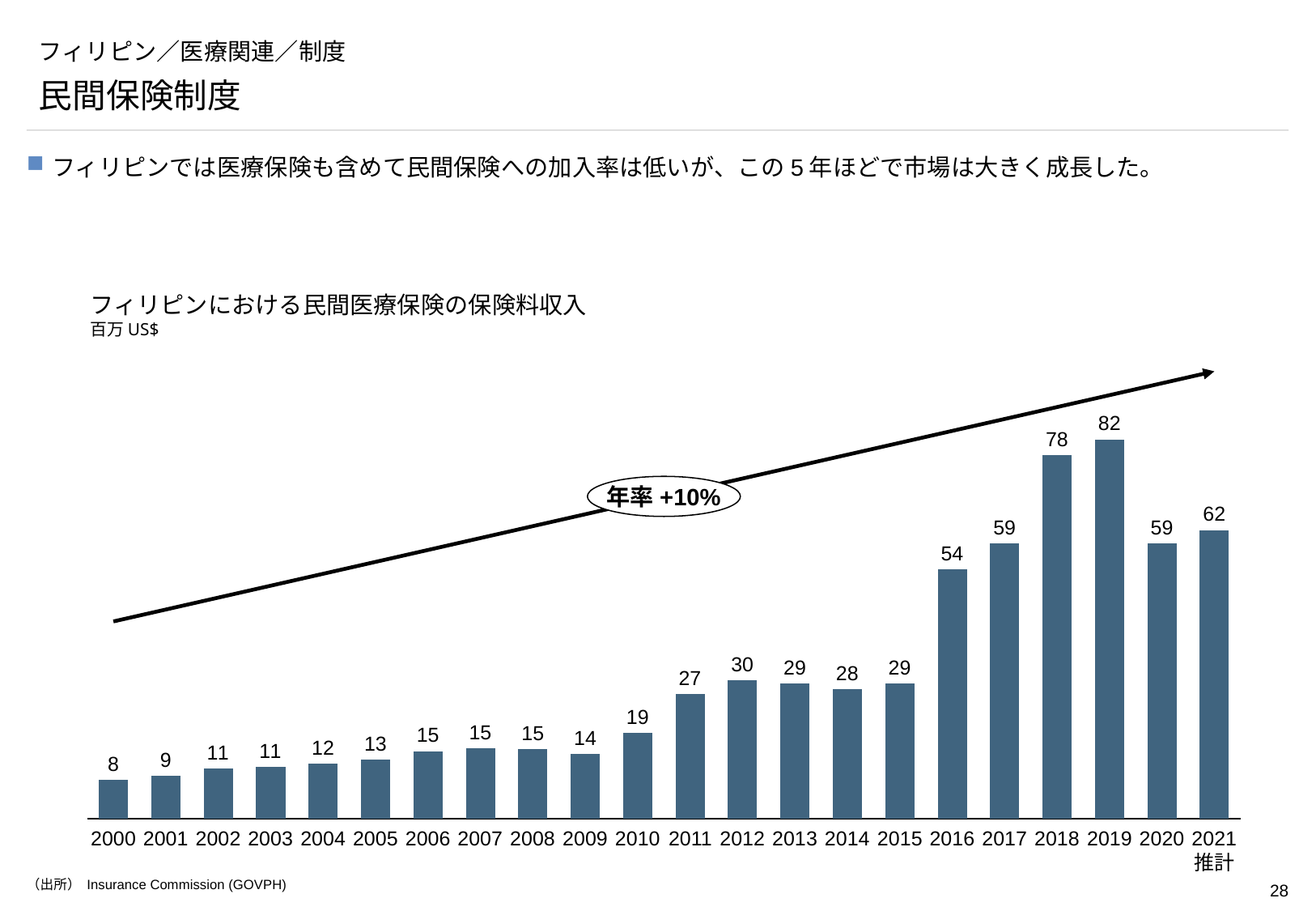
What is the difference between the values for 2019 and 2018? 4 Do the values generally rise or fall from 2000 to 2019? Rise What is the value for 2000? 8 What annual growth rate is written in the oval label on the chart? 年率 +10% Which year has the lowest value? 2000 Which year has the highest value? 2019 Which is larger, the value for 2021 or the value for 2020? 2021 What is the difference between the values for 2016 and 2015? 25 What is the value for 2016? 54 What kind of chart is this? Bar chart How many years are shown on the x axis? 22 What is the value for 2019? 82